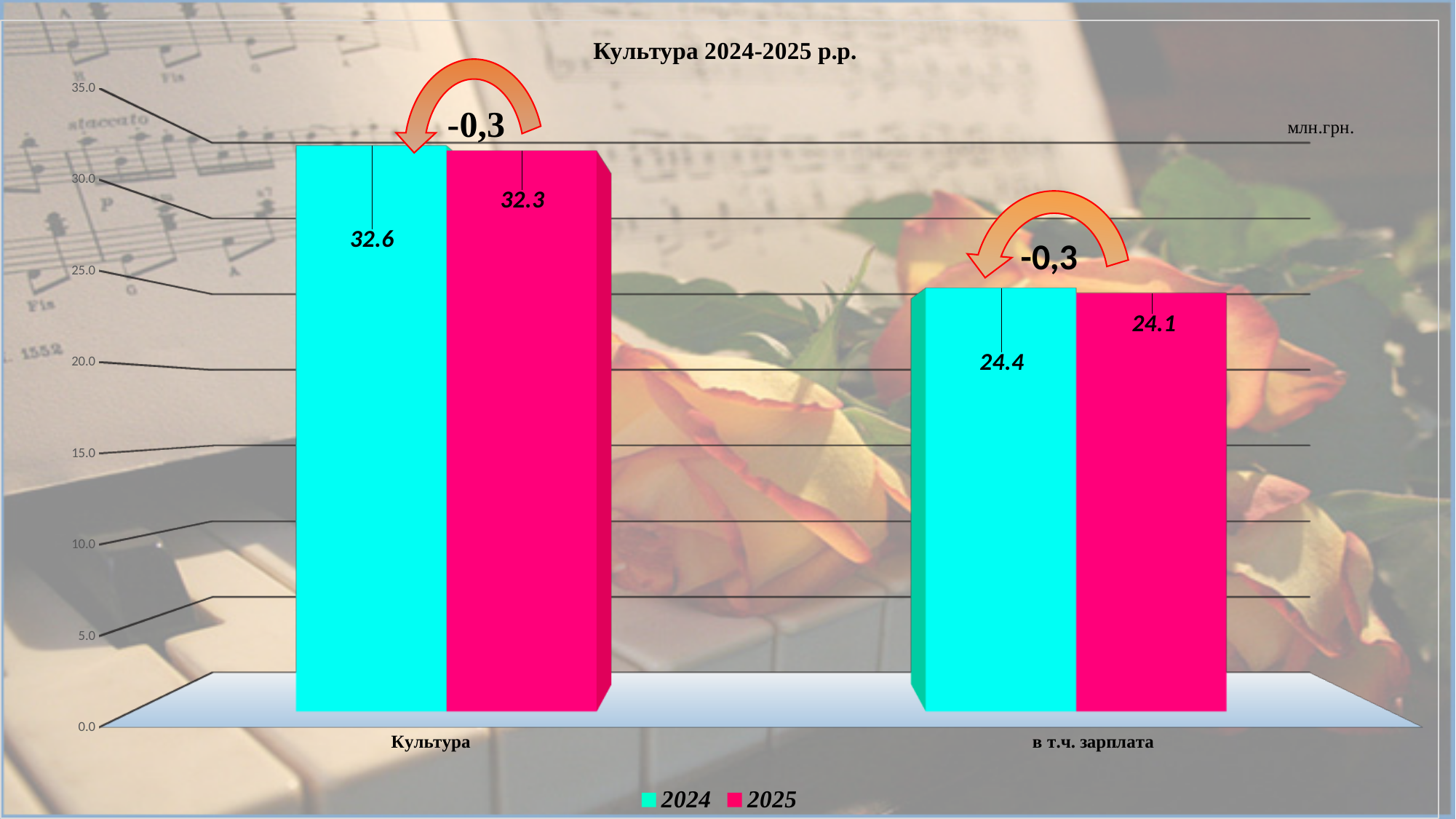
What is the value for 2025 in the "Культура" category? 32.3 Which is larger: the 2025 value for "Культура" or the 2025 value for "в т.ч. зарплата"? Культура How many categories are shown on the x axis? 2 What is the value for 2024 in the "Культура" category? 32.6 What is the difference between the 2024 value for "Культура" and the 2024 value for "в т.ч. зарплата"? 8.2 Which category has the highest 2024 value? Культура What is the value for 2025 in the "в т.ч. зарплата" category? 24.1 What is the value for 2024 in the "в т.ч. зарплата" category? 24.4 How many series does the legend list? 2 Which category has the lowest 2025 value? в т.ч. зарплата What is the title of the chart? Культура 2024-2025 р.р. What is the difference between the 2024 and 2025 values for "Культура"? 0.3